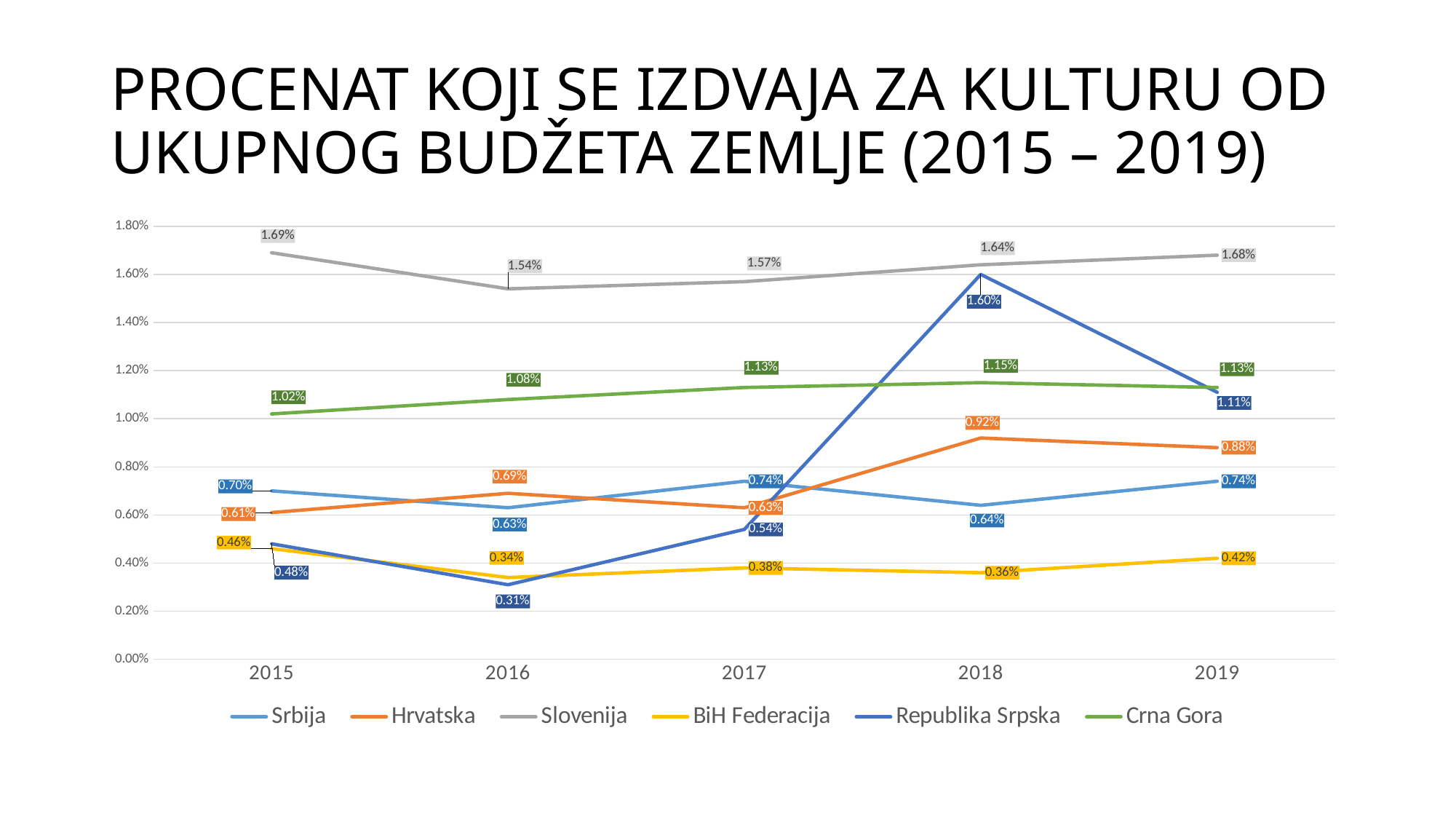
Does the Crna Gora series rise or fall from 2015 to 2018? rise Which series has the highest value in 2019? Slovenija What is the difference between the Slovenija value in 2015 and its value in 2016? 0.15% What type of chart is shown on the slide? line chart What is the value for BiH Federacija in 2016? 0.34% Which series has the lowest value in 2016? Republika Srpska Which is larger in 2017, the value for Srbija or the value for Hrvatska? Srbija What is the value for Hrvatska in 2019? 0.88% How many years are shown on the x axis? 5 What is the value for Slovenija in 2015? 1.69% What is the value for Republika Srpska in 2018? 1.60% How many series does the legend list? 6